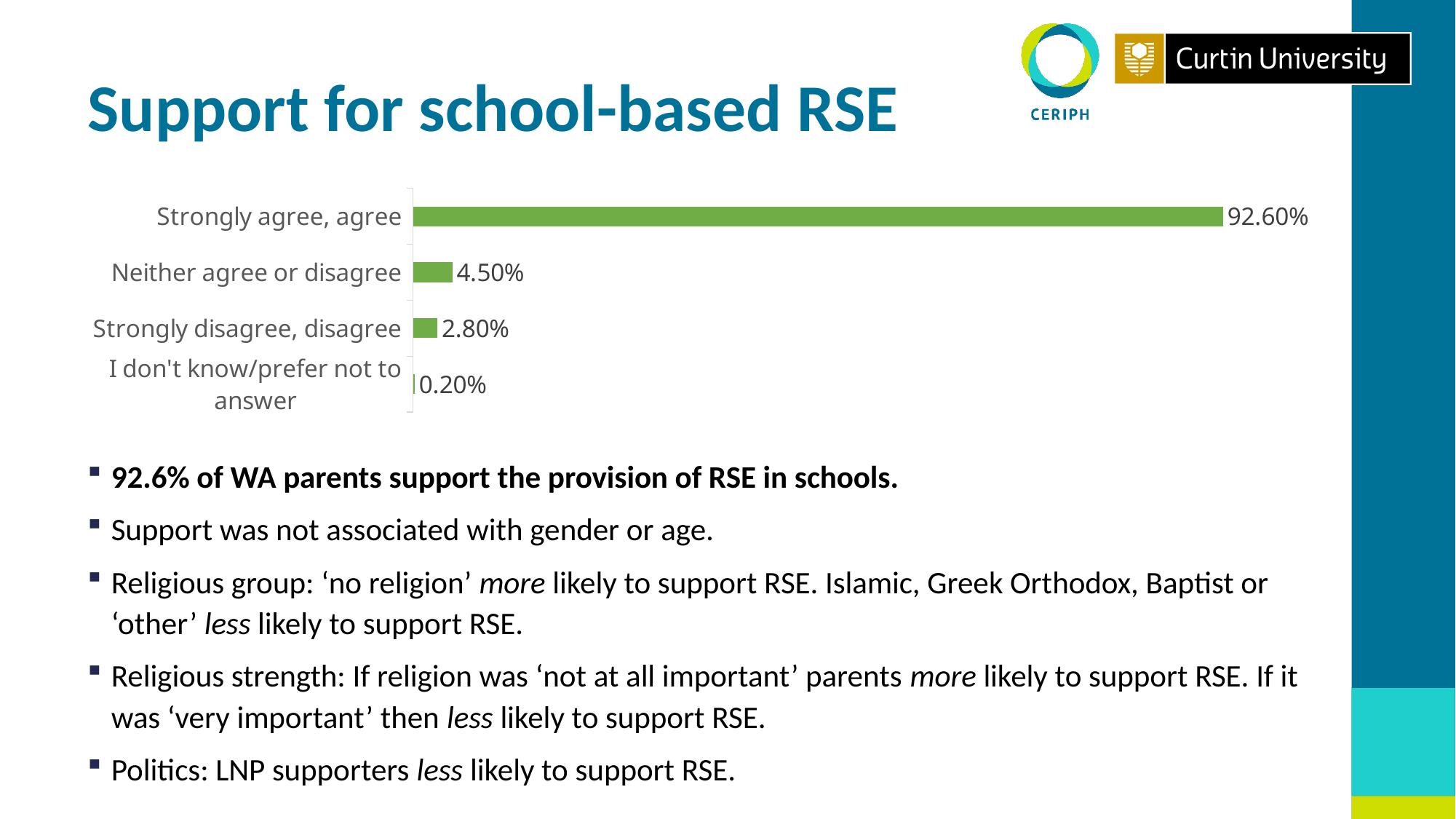
What is the difference between the values for 'Neither agree or disagree' and 'Strongly disagree, disagree'? 1.70% What is the value for 'Neither agree or disagree'? 4.50% What is the value for 'Strongly agree, agree'? 92.60% What is the value for 'Strongly disagree, disagree'? 2.80% What colour are the bars in the chart? Green How many categories are shown in the chart? 4 Which is larger, the value for 'Neither agree or disagree' or the value for 'Strongly disagree, disagree'? Neither agree or disagree Which category has the highest value? Strongly agree, agree What is the value for 'I don't know/prefer not to answer'? 0.20% Which category has the lowest value? I don't know/prefer not to answer What is the difference between the values for 'Strongly agree, agree' and 'Neither agree or disagree'? 88.10% What kind of chart is shown on the slide? Bar chart